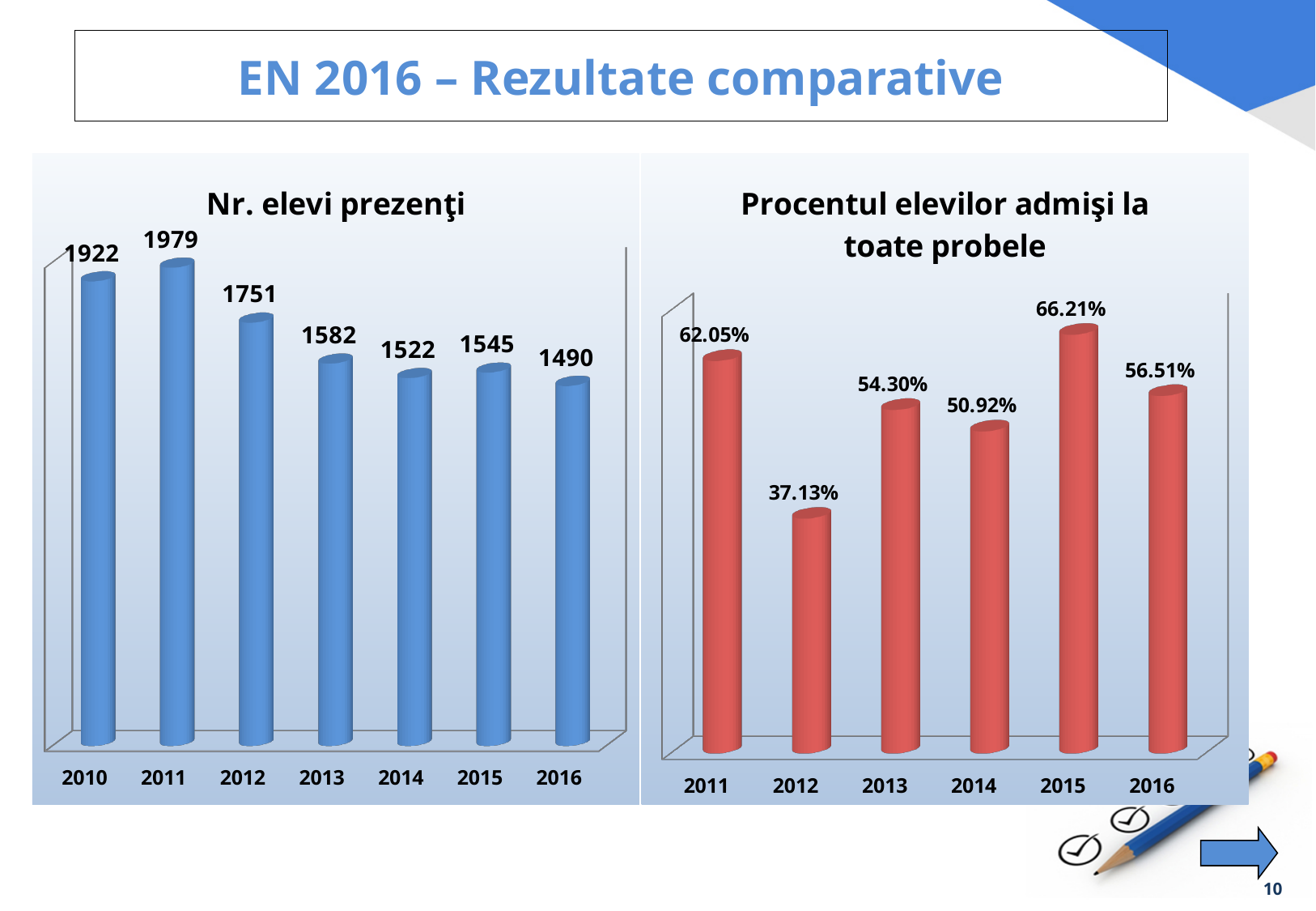
In the 'Procentul elevilor admişi la toate probele' chart, how many years are shown? 6 In the 'Procentul elevilor admişi la toate probele' chart, what is the value for 2014? 50.92% In the 'Nr. elevi prezenţi' chart, what is the difference between the values for 2010 and 2016? 432 In the 'Nr. elevi prezenţi' chart, is the value for 2014 larger or smaller than the value for 2015? smaller What kind of chart is the 'Procentul elevilor admişi la toate probele' chart? bar chart In the 'Nr. elevi prezenţi' chart, which year has the lowest value? 2016 In the 'Nr. elevi prezenţi' chart, which year has the highest value? 2011 In the 'Nr. elevi prezenţi' chart, what is the value for 2012? 1751 In the 'Procentul elevilor admişi la toate probele' chart, which year has the highest value? 2015 In the 'Procentul elevilor admişi la toate probele' chart, which year has the lowest value? 2012 In the 'Procentul elevilor admişi la toate probele' chart, what is the difference between the values for 2015 and 2016? 9.70% In the 'Nr. elevi prezenţi' chart, how many years are shown? 7